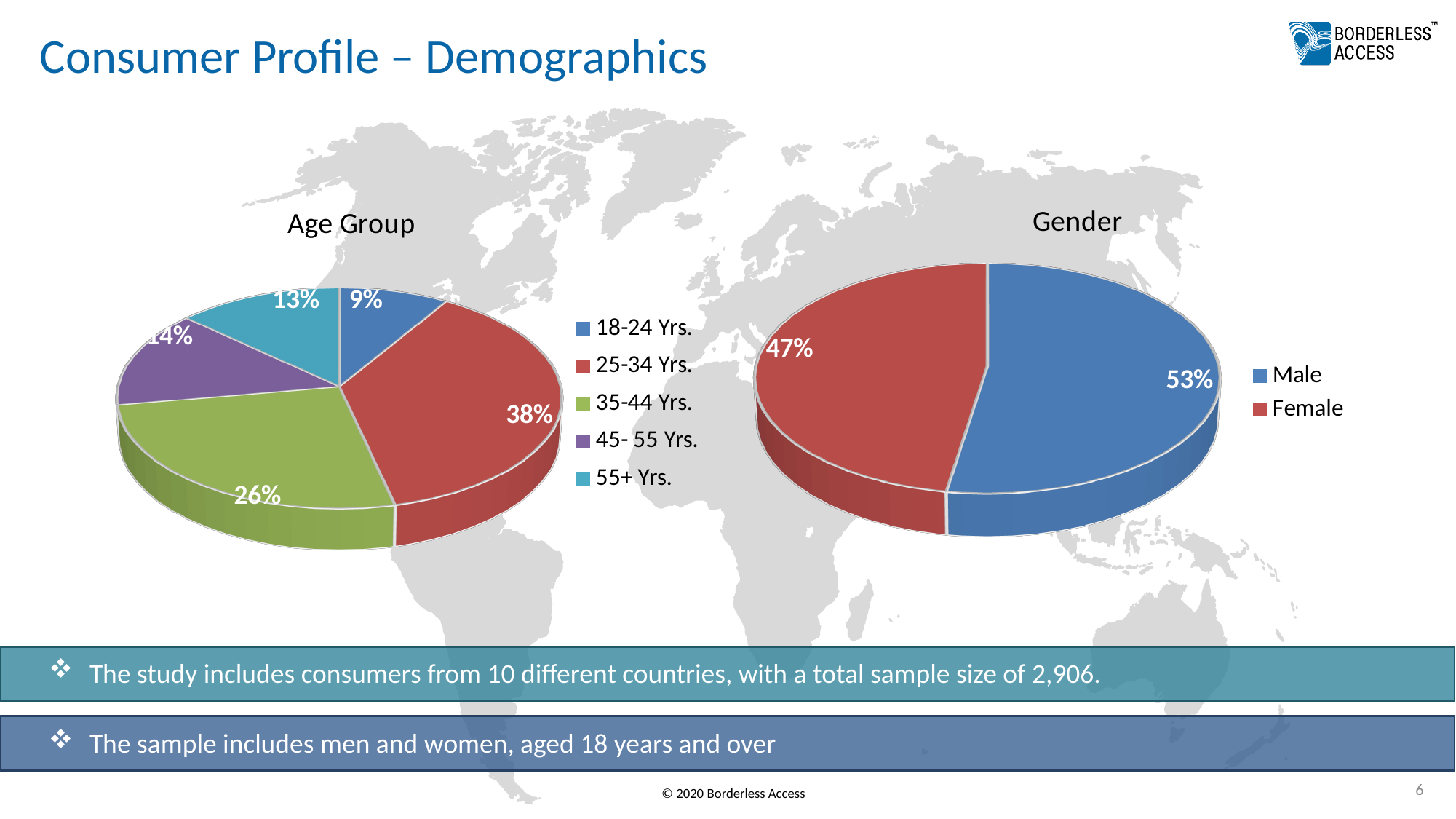
In the Gender pie chart, which is larger, Male or Female? Male In the Gender pie chart, what share is Male? 53% In the Age Group pie chart, which age group has the smallest share? 18-24 Yrs. In the Age Group pie chart, what is the difference between the 25-34 Yrs. share and the 35-44 Yrs. share? 12% In the Age Group pie chart, what share is the 18-24 Yrs. slice? 9% In the Age Group pie chart, how many age groups are shown? 5 In the Age Group pie chart, what share is the 55+ Yrs. slice? 13% In the Gender pie chart, what share is Female? 47% In the Age Group pie chart, what share is the 35-44 Yrs. slice? 26% In the Age Group pie chart, what share is the 25-34 Yrs. slice? 38% What kind of chart is the Gender chart? Pie chart In the Age Group pie chart, which age group has the largest share? 25-34 Yrs.